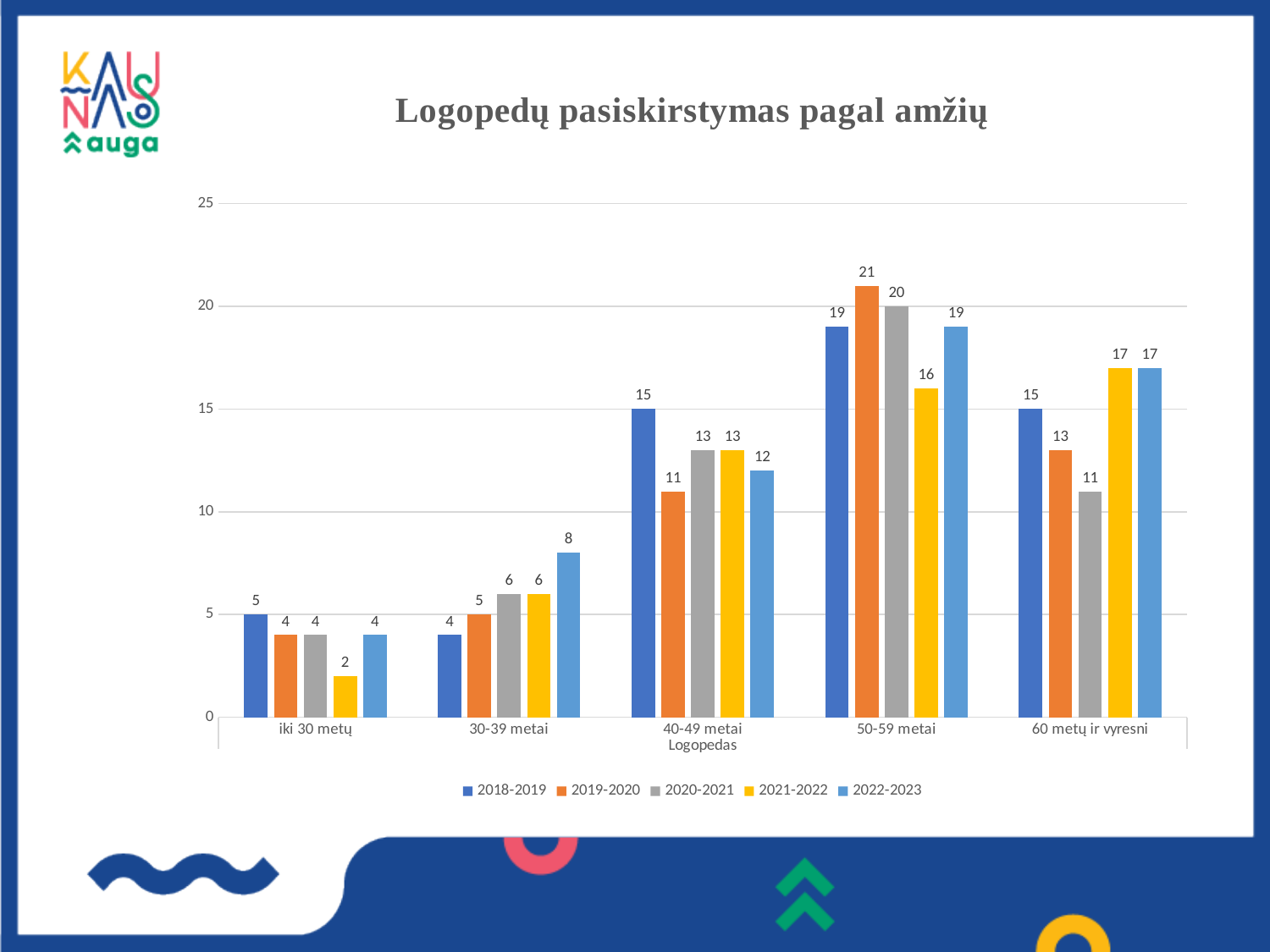
What is the value for iki 30 metų in the 2021-2022 series? 2 Which age category has the lowest value in the 2022-2023 series? iki 30 metų What is the value for 50-59 metai in the 2019-2020 series? 21 Which is larger for 40-49 metai: the 2018-2019 value or the 2019-2020 value? 2018-2019 How many age categories are shown on the x axis? 5 What is the title of the chart? Logopedų pasiskirstymas pagal amžių What is the value for 60 metų ir vyresni in the 2020-2021 series? 11 How many series does the legend list? 5 What is the difference between the 2019-2020 and 2021-2022 values for 50-59 metai? 5 Which age category has the highest value in the 2018-2019 series? 50-59 metai What kind of chart is shown on the slide? bar chart Do the values for the 2021-2022 series rise or fall from 30-39 metai to 50-59 metai? rise